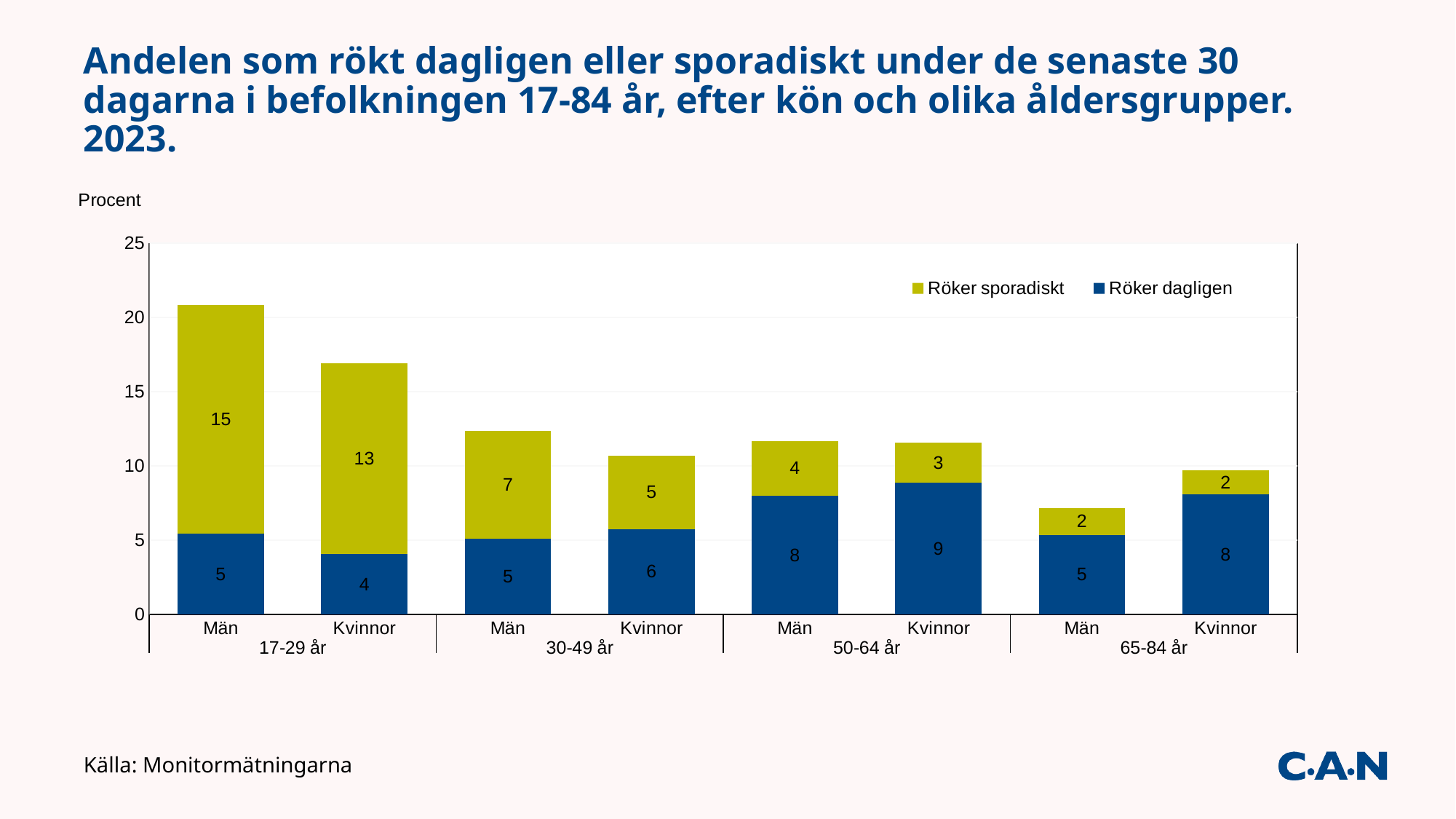
How many bars are plotted in the chart? 8 What is the value of Röker sporadiskt for Kvinnor in the 65-84 år group? 2 Is the total height of the bar for Män in the 17-29 år group greater or less than 20? greater Which bar has the highest Röker sporadiskt value? Män, 17-29 år What is the value of Röker sporadiskt for Män in the 17-29 år group? 15 How many series does the legend list? 2 Is the Röker dagligen value larger for Män or Kvinnor in the 65-84 år group? Kvinnor What is the value of Röker dagligen for Kvinnor in the 50-64 år group? 9 What type of chart is shown on the slide? Stacked bar chart Which bar has the lowest Röker dagligen value? Kvinnor, 17-29 år What is the difference between the Röker sporadiskt values for Män and Kvinnor in the 17-29 år group? 2 What are the two series named in the legend? Röker sporadiskt and Röker dagligen